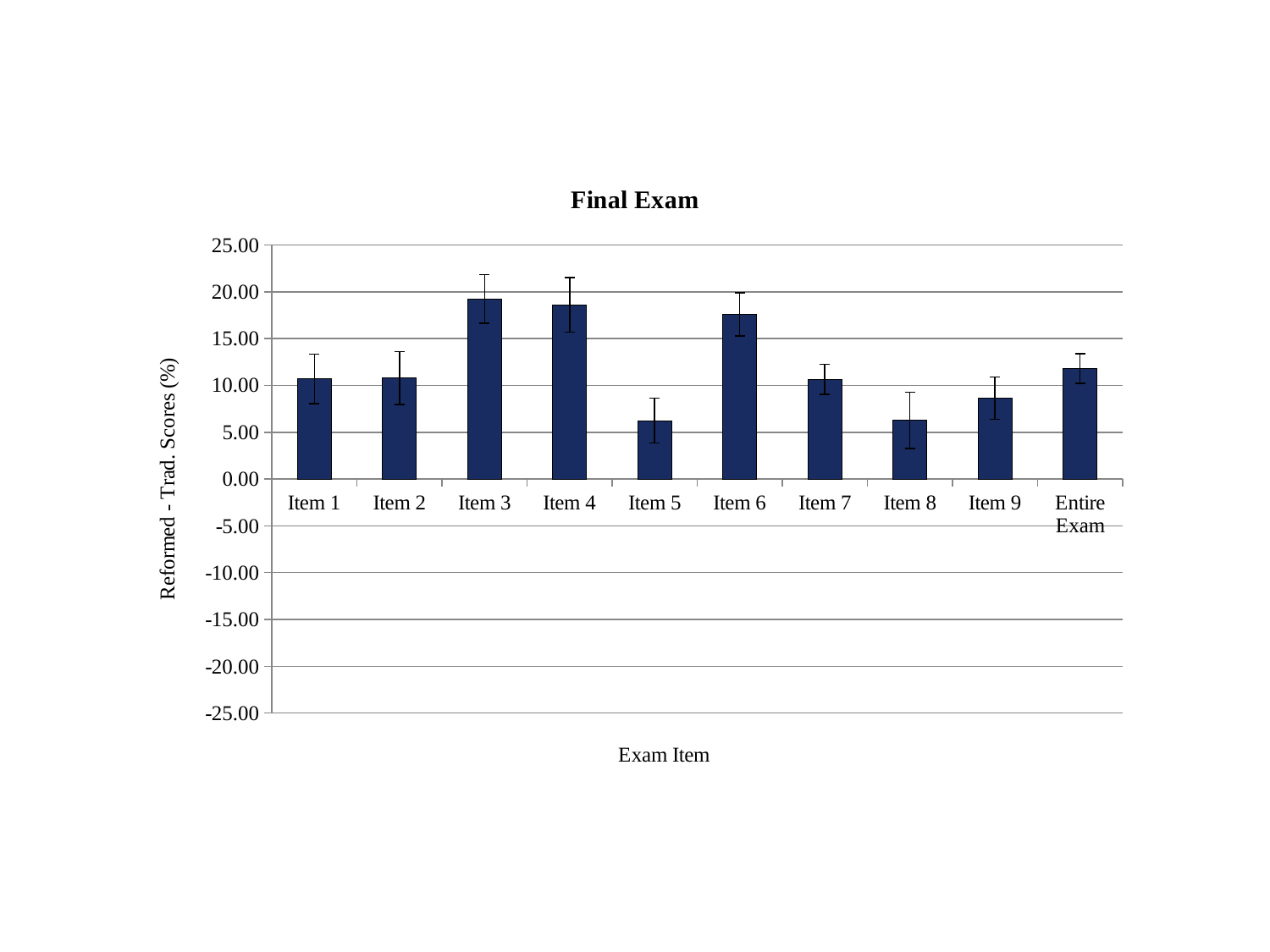
Is the value for Item 3 greater or less than 15.00? greater Which has the larger value, Item 6 or Item 9? Item 6 What kind of chart is shown on the slide? bar chart Is the value for Item 4 greater or less than 15.00? greater Which has the larger value, Item 3 or Item 5? Item 3 Is the value for Item 6 greater or less than 15.00? greater How many categories are plotted along the x axis? 10 What is the title of the chart? Final Exam What is the label of the x axis? Exam Item